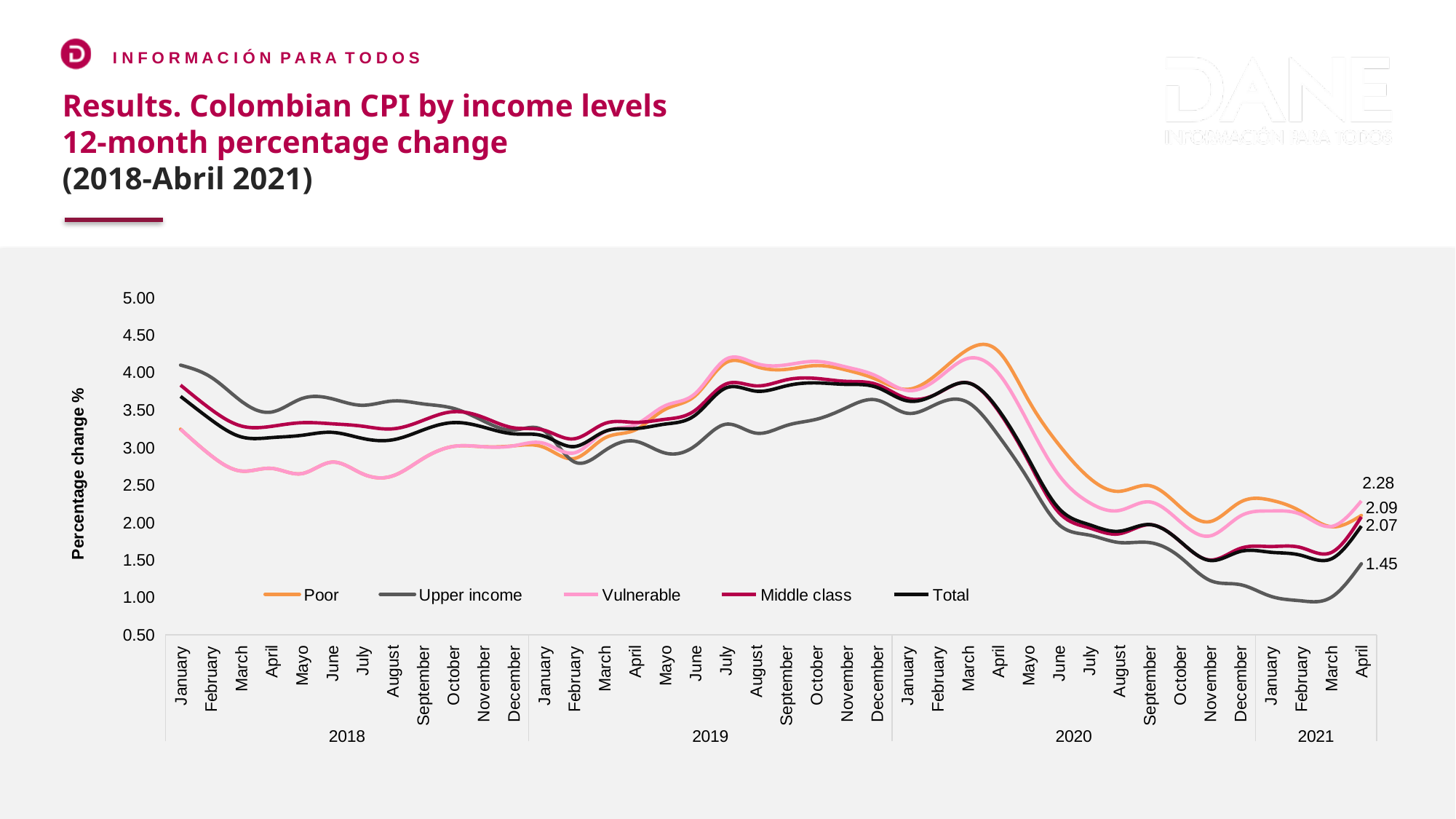
What is the difference between the Vulnerable and Upper income values in April 2021? 0.83 What is the value for Upper income in April 2021? 1.45 What kind of chart is shown on the slide? line chart What is the value for Vulnerable in April 2021? 2.28 Which series has the lowest value in April 2021? Upper income Does the Total series rise or fall between April 2020 and June 2020? fall Is the value for Upper income in June 2020 greater or less than 2.50? less What is the label on the vertical axis? Percentage change % Which series has the highest value in April 2021? Vulnerable Is the value for Poor in April 2020 greater or less than 4.00? greater How many series does the legend list? 5 In April 2021, which is larger: the value for Vulnerable or the value for Upper income? Vulnerable